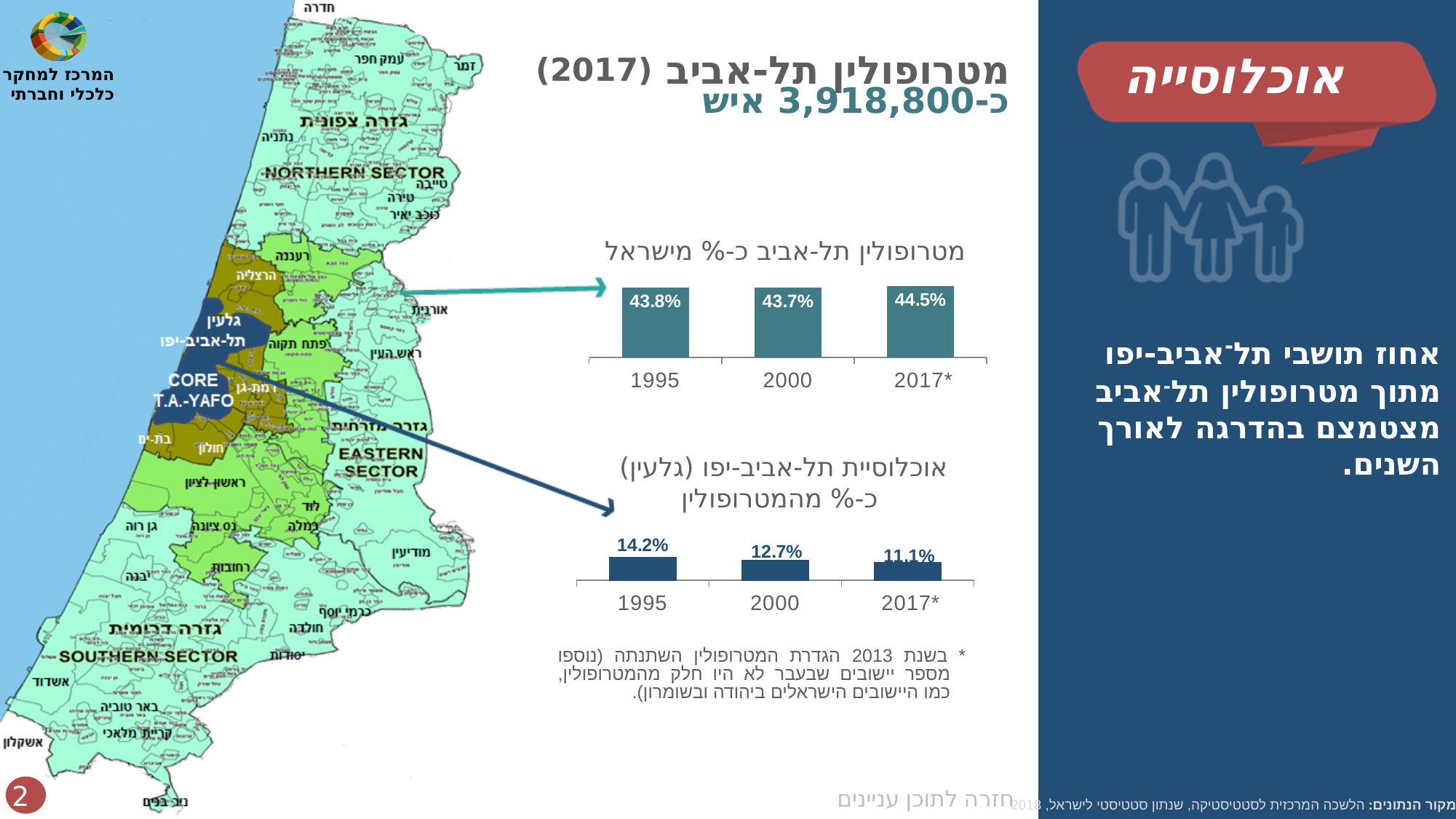
In the bottom chart (Tel Aviv-Yafo core population as % of the metropolitan area), what is the value for 2017*? 11.1% In the bottom chart (Tel Aviv-Yafo core population as % of the metropolitan area), do the values rise or fall from 1995 to 2017*? fall In the bottom chart (Tel Aviv-Yafo core population as % of the metropolitan area), what is the difference between the 1995 and 2017* values? 3.1% In the top chart (Tel Aviv metropolitan area as % of Israel), what is the value for 1995? 43.8% What type of chart is the bottom chart (Tel Aviv-Yafo core population as % of the metropolitan area)? bar chart In the top chart (Tel Aviv metropolitan area as % of Israel), which year has the lowest value? 2000 How many bars are shown in the top chart (Tel Aviv metropolitan area as % of Israel)? 3 In the top chart (Tel Aviv metropolitan area as % of Israel), which year has the highest value? 2017* In the top chart (Tel Aviv metropolitan area as % of Israel), is the value for 2000 larger or smaller than the value for 2017*? smaller In the top chart (Tel Aviv metropolitan area as % of Israel), what is the value for 2017*? 44.5% In the bottom chart (Tel Aviv-Yafo core population as % of the metropolitan area), which year has the highest value? 1995 In the bottom chart (Tel Aviv-Yafo core population as % of the metropolitan area), what is the value for 2000? 12.7%